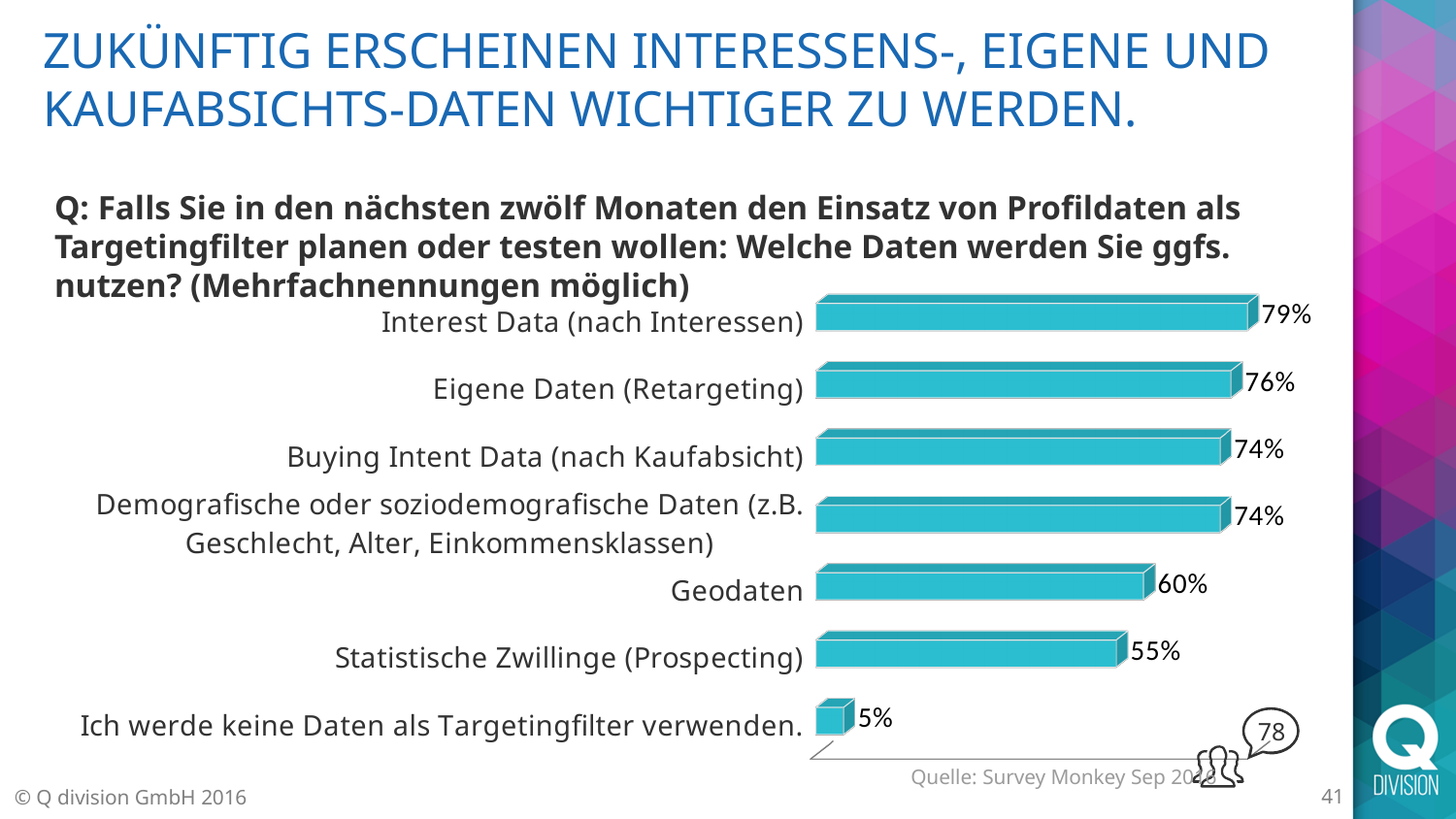
What is the difference between Interest Data (nach Interessen) and Eigene Daten (Retargeting)? 3 percentage points What is the value for Statistische Zwillinge (Prospecting)? 55% Which is larger, Eigene Daten (Retargeting) or Geodaten? Eigene Daten (Retargeting) What is the value for Interest Data (nach Interessen)? 79% Which category has the lowest value? Ich werde keine Daten als Targetingfilter verwenden What is the difference between Geodaten and Statistische Zwillinge (Prospecting)? 5 percentage points Which category has the highest value? Interest Data (nach Interessen) What is the value for Geodaten? 60% What kind of chart is shown on the slide? Bar chart What is the value for Ich werde keine Daten als Targetingfilter verwenden? 5% How many categories are shown in the chart? 7 What is the value for Buying Intent Data (nach Kaufabsicht)? 74%